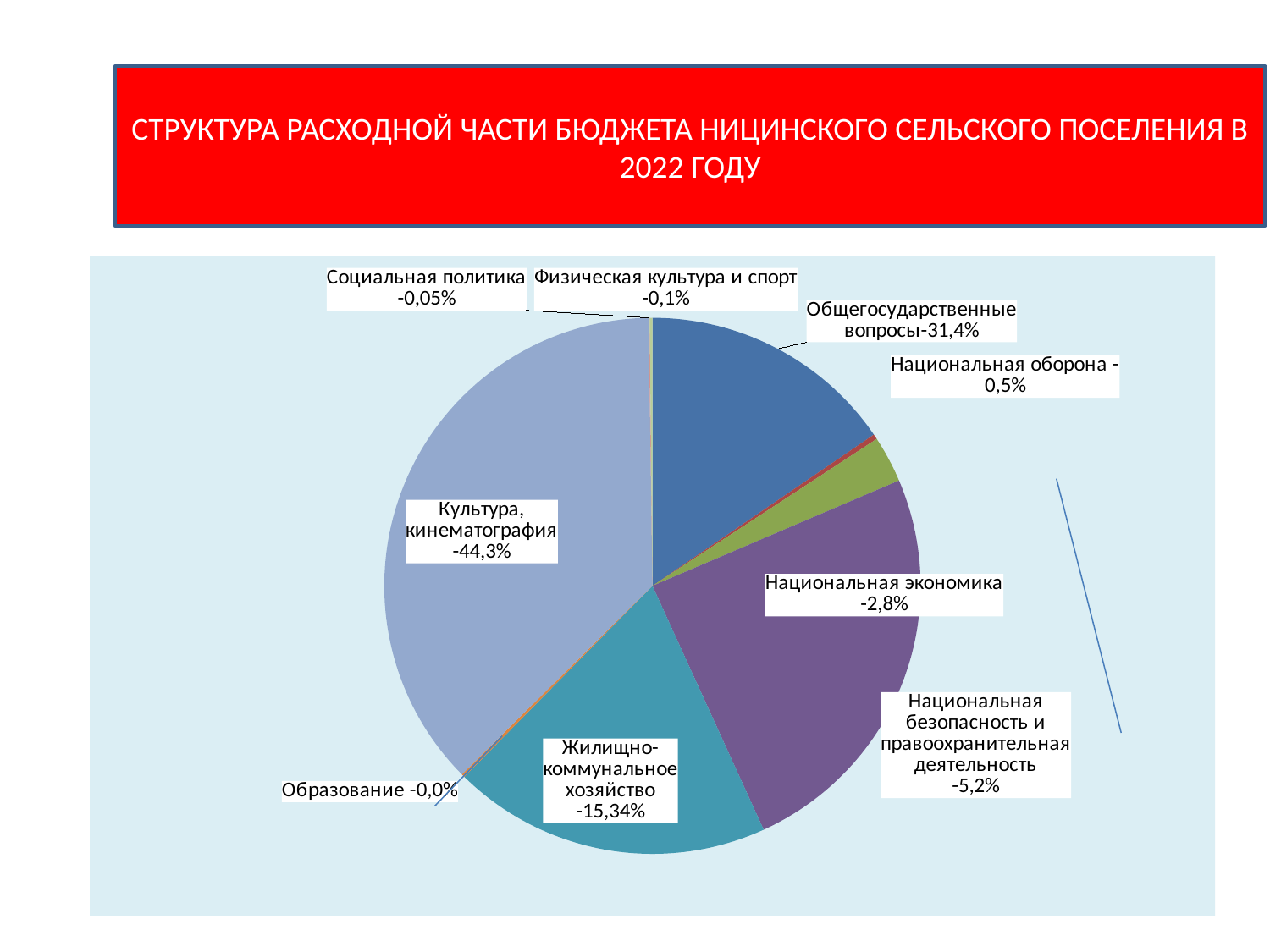
How many categories are shown in the pie chart? 9 What is the difference in percentage points between Культура, кинематография and Общегосударственные вопросы? 12,9% What share is shown for Национальная оборона? 0,5% What share is shown for Общегосударственные вопросы? 31,4% What share is shown for Жилищно-коммунальное хозяйство? 15,34% Which category has the largest share of the budget expenditure? Культура, кинематография What year does the budget expenditure structure in the slide title refer to? 2022 What share of the budget expenditure goes to Культура, кинематография? 44,3% What kind of chart is shown on the slide? Pie chart Which category has the smallest share of the budget expenditure? Образование What share is shown for Национальная безопасность и правоохранительная деятельность? 5,2% Which is larger: the share for Национальная экономика or the share for Национальная безопасность и правоохранительная деятельность? Национальная безопасность и правоохранительная деятельность